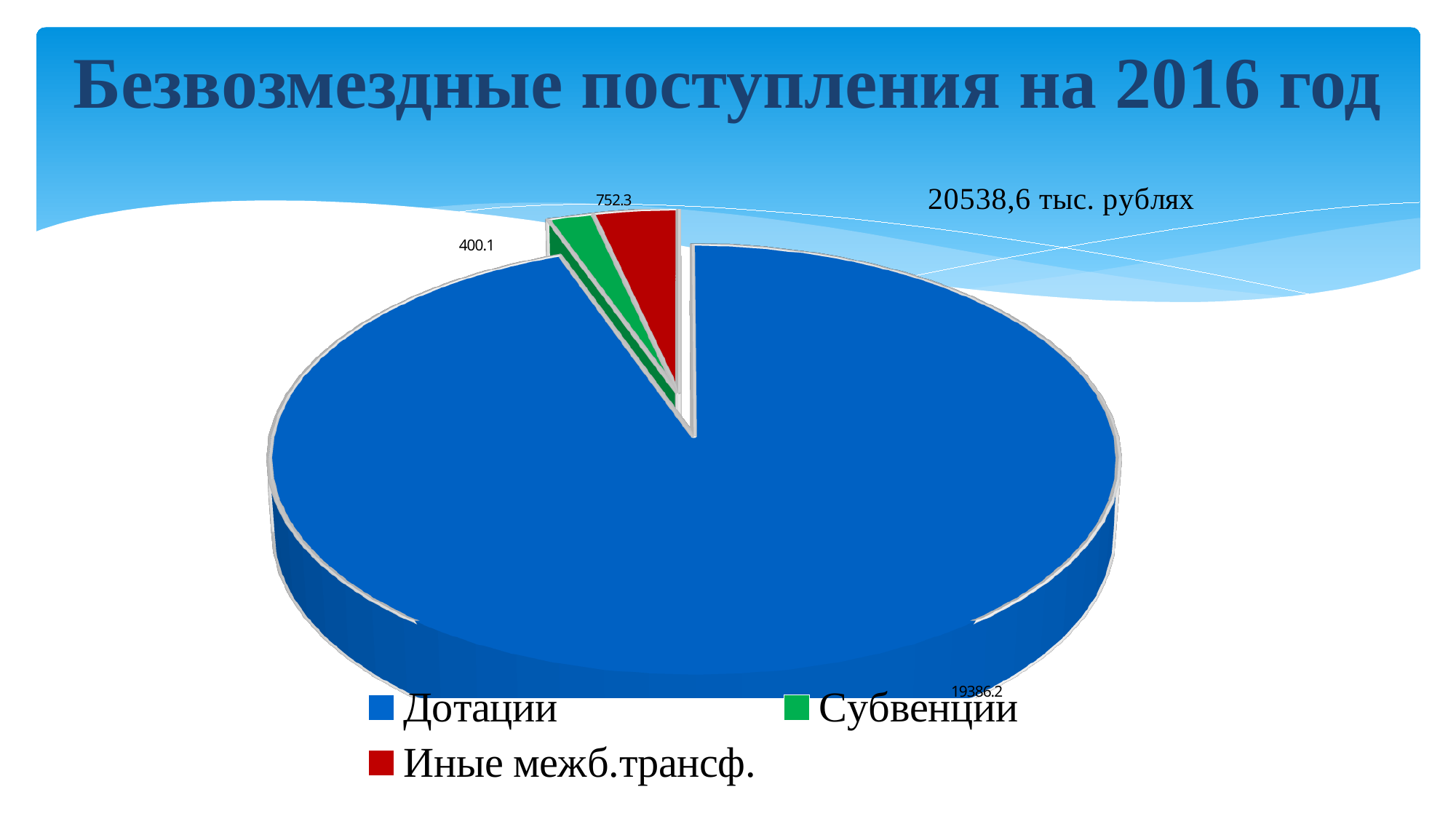
How many categories does the pie chart have? 3 What type of chart is shown on the slide? Pie chart Which category has the smallest slice of the pie? Субвенции What is the value for Иные межб.трансф.? 752.3 What is the value for Субвенции? 400.1 Which is larger, Иные межб.трансф. or Субвенции? Иные межб.трансф. What colour is the slice for Субвенции? Green What is the value for Дотации? 19386.2 What is the difference between the values for Иные межб.трансф. and Субвенции? 352.2 Which category has the largest slice of the pie? Дотации What is the difference between the values for Дотации and Иные межб.трансф.? 18633.9 What is the title of the slide? Безвозмездные поступления на 2016 год